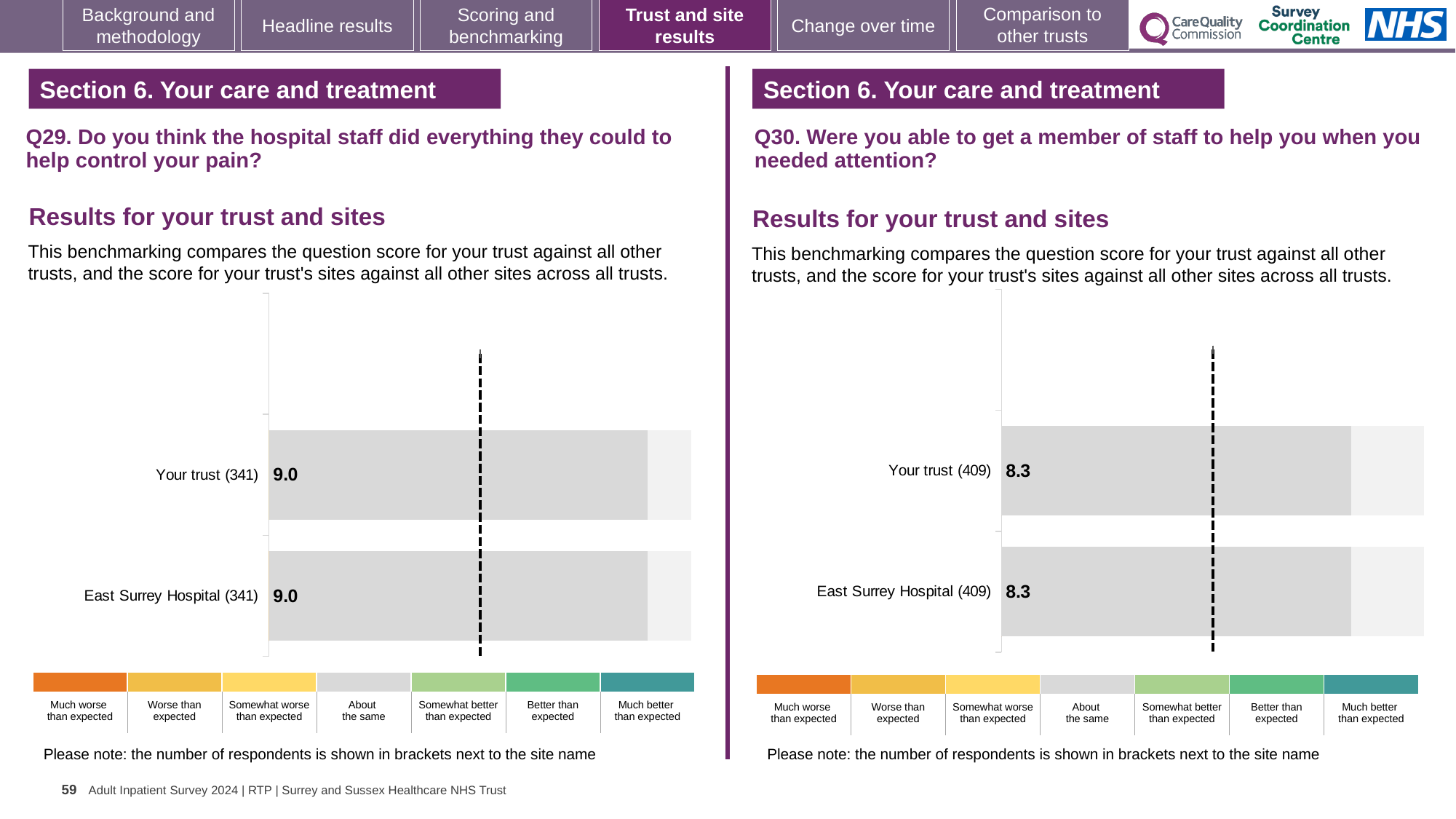
On the Q29 chart (left), what is the difference between the score for Your trust and the score for East Surrey Hospital? 0.0 Is the score for Your trust on the Q29 chart (left) larger or smaller than the score for Your trust on the Q30 chart (right)? Larger How many bars are plotted on the Q30 chart (right)? 2 On the Q30 chart (right), what is the score for East Surrey Hospital? 8.3 On the Q30 chart (right), how many respondents are shown in brackets next to East Surrey Hospital? 409 What kind of chart is used on the Q29 chart (left)? Bar chart On the Q29 chart (left), what is the score for Your trust? 9.0 On the Q30 chart (right), what is the score for Your trust? 8.3 On the Q29 chart (left), how many respondents are shown in brackets next to Your trust? 341 On the Q29 chart (left), what is the score for East Surrey Hospital? 9.0 How many bars are plotted on the Q29 chart (left)? 2 On the Q30 chart (right), what is the difference between the score for Your trust and the score for East Surrey Hospital? 0.0